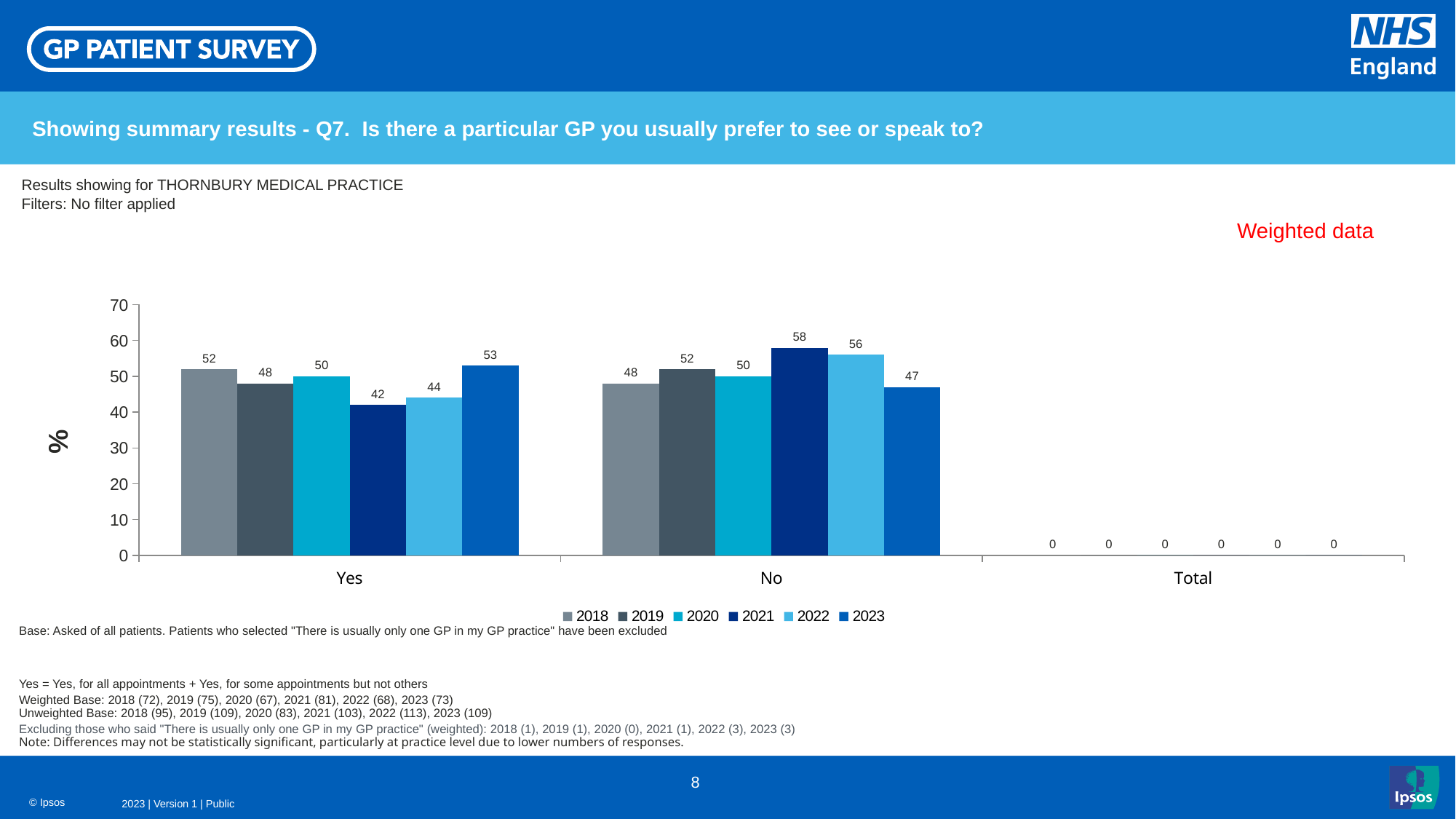
Which is larger: the 2022 value for Yes or the 2022 value for No? No What kind of chart is shown on the slide? Bar chart How many series does the legend list? 6 Which year has the lowest value in the Yes category? 2021 Which year has the highest value in the No category? 2021 What value is shown for every year in the Total category? 0 What is the label on the vertical axis? % What is the value for 2018 in the Yes category? 52 What is the value for 2023 in the Yes category? 53 How many categories are shown on the x axis? 3 What is the value for 2021 in the No category? 58 What is the difference between the 2021 and 2023 values in the No category? 11